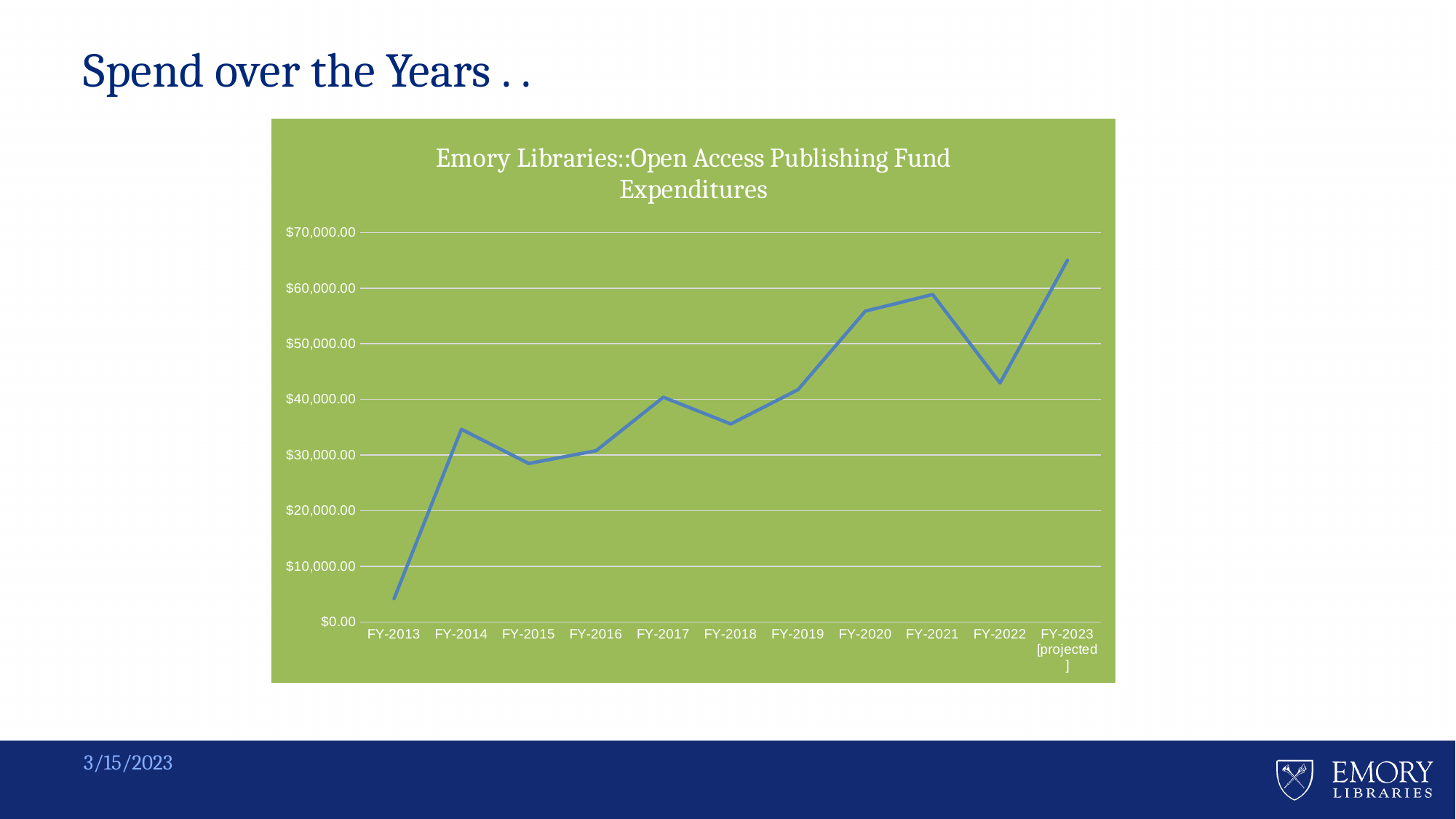
Is the value for FY-2015 greater or less than $30,000.00? less Which is larger, the expenditure for FY-2014 or FY-2015? FY-2014 How many fiscal years are plotted on the x axis? 11 What is the title of the chart? Emory Libraries::Open Access Publishing Fund Expenditures Which fiscal year has the highest expenditure? FY-2023 [projected] Is the value for FY-2013 greater or less than $10,000.00? less Which fiscal year has the lowest expenditure? FY-2013 Is the value for FY-2020 greater or less than $50,000.00? greater Which is larger, the expenditure for FY-2020 or FY-2022? FY-2020 Overall, do expenditures rise or fall from FY-2013 to FY-2023? rise What kind of chart is shown on the slide? line chart